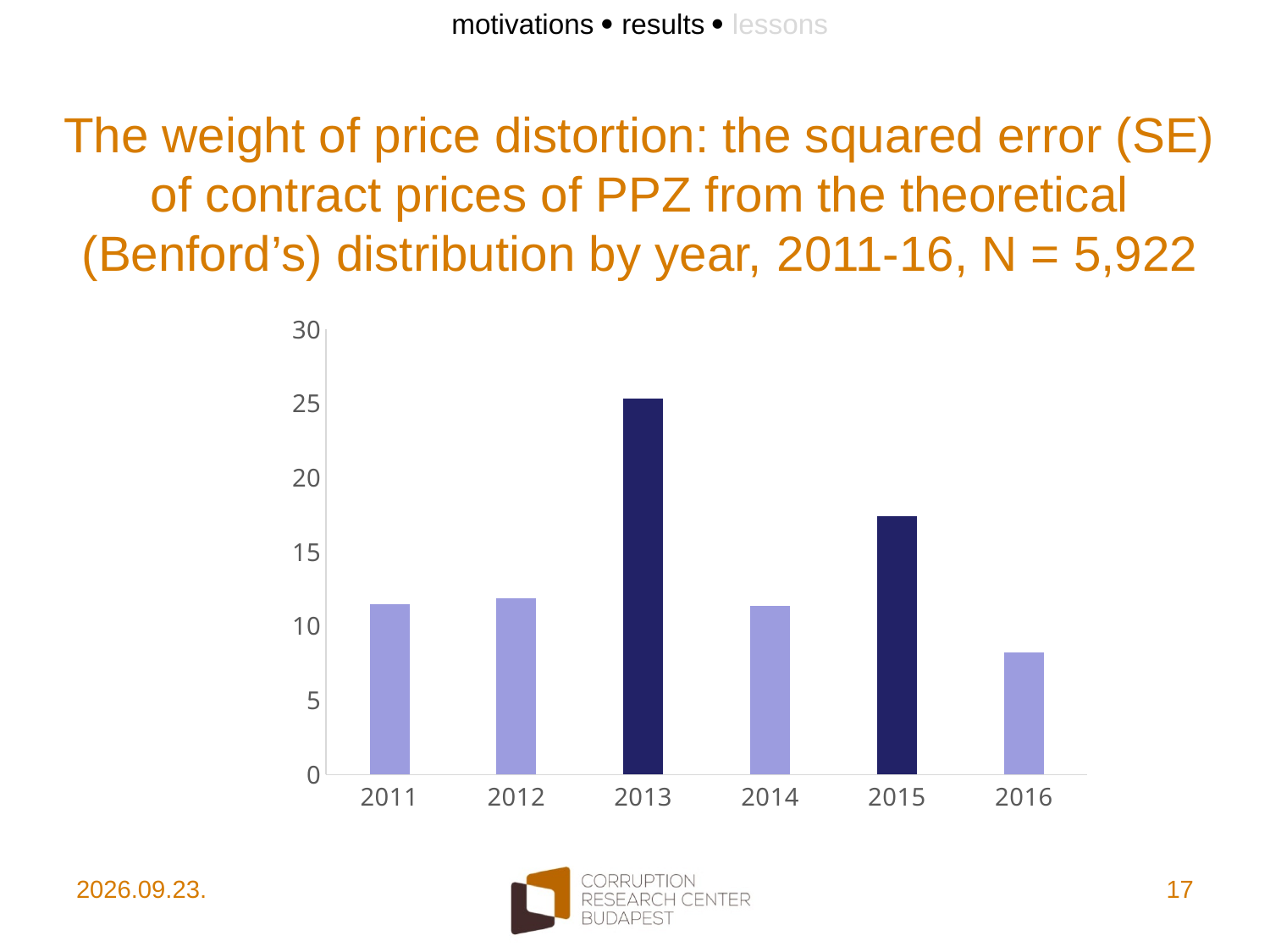
Is the value for 2015 greater or less than 15? greater Is the value for 2011 greater or less than 10? greater Which year has the lowest squared error in the chart? 2016 Is the value for 2016 greater or less than 10? less How many years are shown on the x axis of the chart? 6 What kind of chart is shown on the slide? bar chart Which two years are drawn with dark navy bars instead of light purple bars? 2013 and 2015 Which is larger, the value for 2015 or the value for 2016? 2015 Which year has the highest squared error in the chart? 2013 Which is larger, the value for 2013 or the value for 2015? 2013